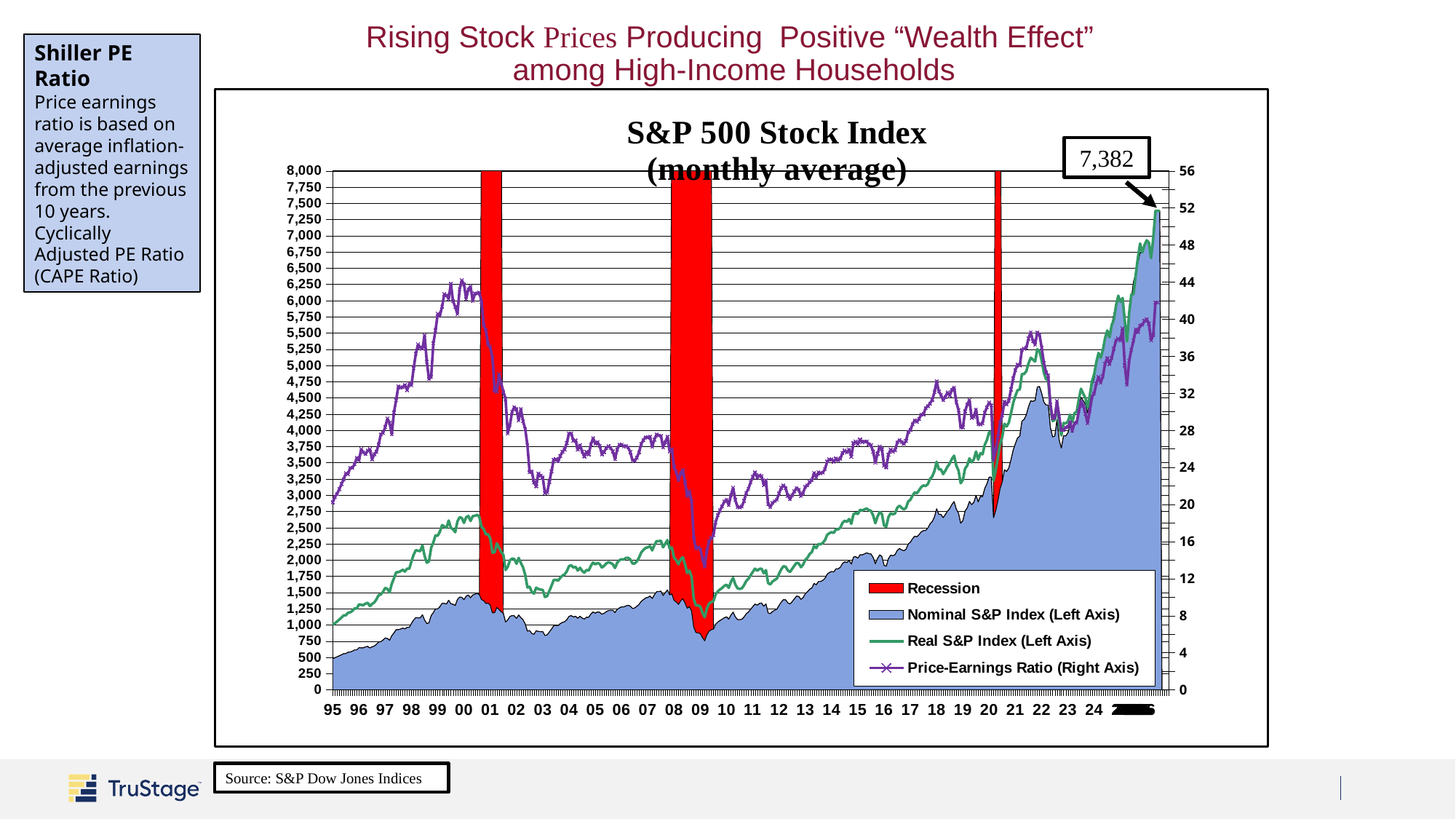
How many recession periods are shaded in red on the chart? 3 Does the Nominal S&P Index generally rise or fall from 95 to 24? rise How many entries does the chart's legend list? 4 Around 2000, which was higher: the Real S&P Index or the Nominal S&P Index? Real S&P Index What is the title of the chart? S&P 500 Stock Index (monthly average) Is the Price-Earnings Ratio at its peak around 2000 greater or less than 40? greater Is the Nominal S&P Index at its 2009 low greater or less than 1,000? less What value is labeled at the end of the S&P 500 index line in the chart? 7,382 What kind of chart is shown on the slide? combination area and line chart Is the Real S&P Index at the start of the chart in 95 greater or less than 1,500? less Which axis does the Price-Earnings Ratio series use? Right axis